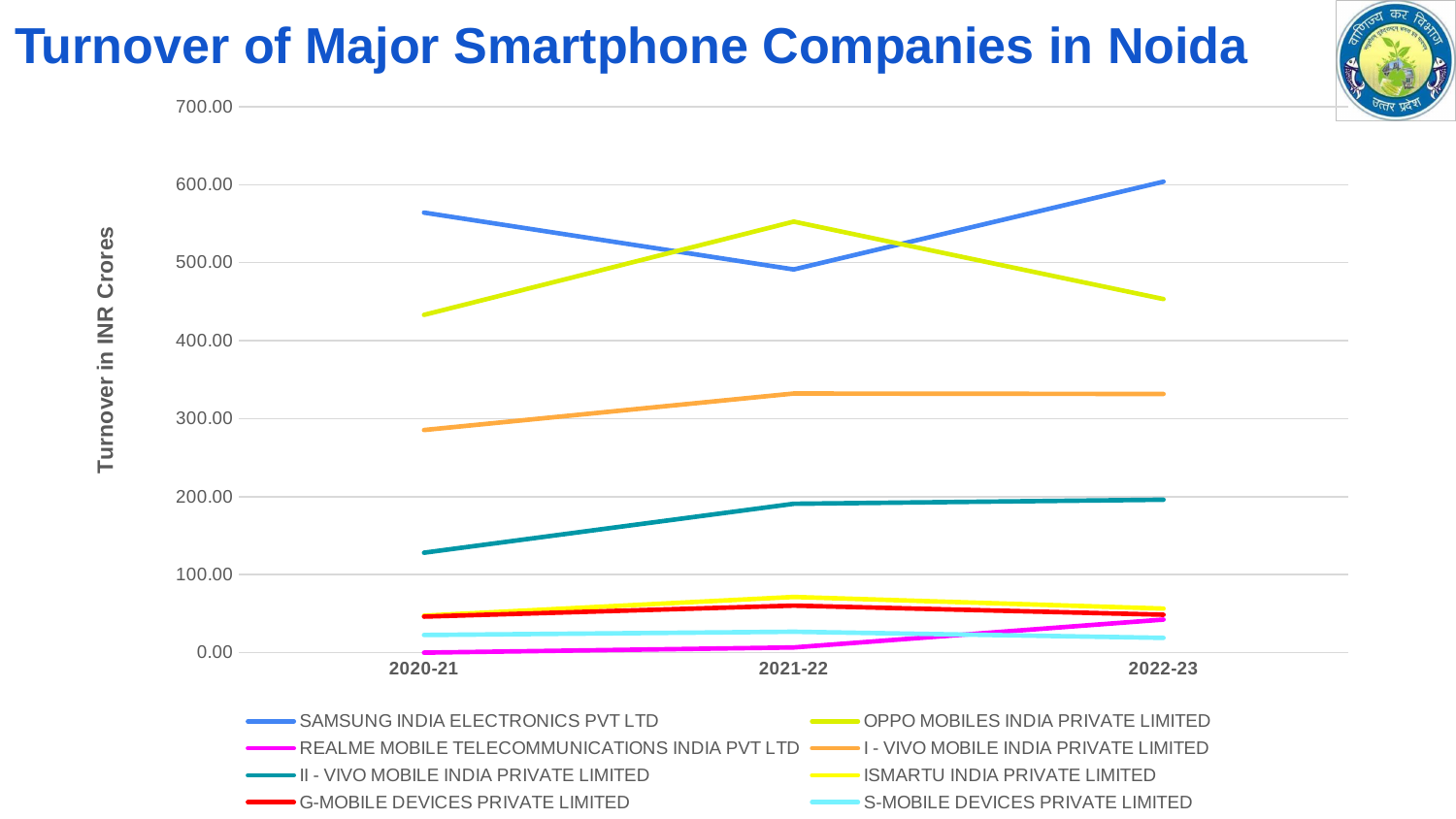
Which company has the highest turnover in 2021-22? OPPO MOBILES INDIA PRIVATE LIMITED What kind of chart is shown on the slide? line chart How many series does the legend list? 8 How many financial years are shown on the x axis? 3 What is the label of the vertical axis? Turnover in INR Crores In 2021-22, which has the larger turnover: SAMSUNG INDIA ELECTRONICS PVT LTD or OPPO MOBILES INDIA PRIVATE LIMITED? OPPO MOBILES INDIA PRIVATE LIMITED Is the turnover of SAMSUNG INDIA ELECTRONICS PVT LTD in 2020-21 greater or less than 500.00? greater Which company has the lowest turnover in 2020-21? REALME MOBILE TELECOMMUNICATIONS INDIA PVT LTD Does the turnover of REALME MOBILE TELECOMMUNICATIONS INDIA PVT LTD rise or fall from 2020-21 to 2022-23? rise Which company has the highest turnover in 2022-23? SAMSUNG INDIA ELECTRONICS PVT LTD Is the turnover of I - VIVO MOBILE INDIA PRIVATE LIMITED in 2020-21 greater or less than 300.00? less Is the turnover of II - VIVO MOBILE INDIA PRIVATE LIMITED in 2020-21 greater or less than 100.00? greater